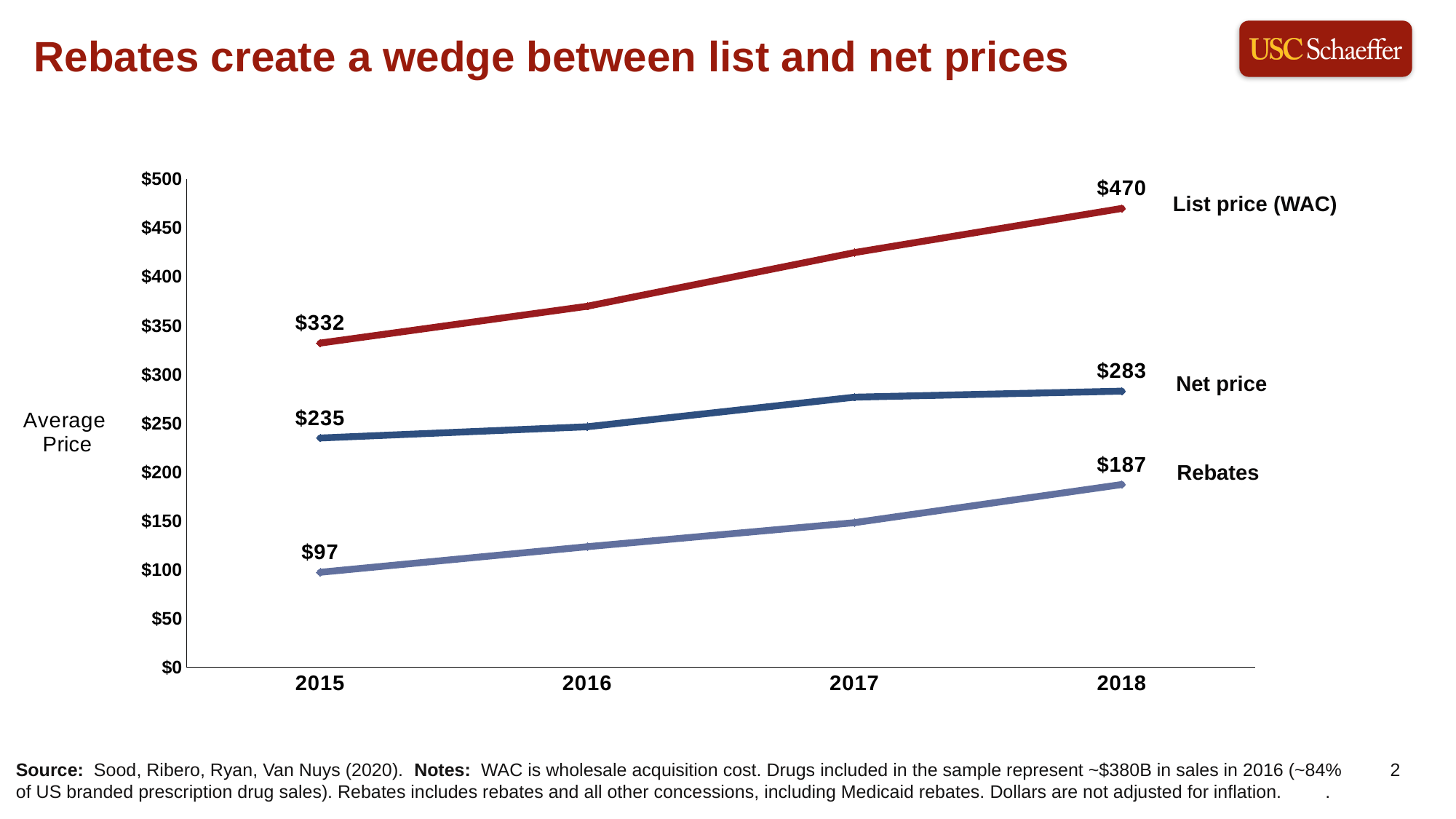
What kind of chart is shown on the slide? Line chart Which series has the highest value in 2018? List price (WAC) What was the List price (WAC) in 2015? $332 What was the Net price in 2015? $235 By how much did the List price (WAC) increase from 2015 to 2018? $138 What is the difference between the List price (WAC) and the Net price in 2018? $187 What was the List price (WAC) in 2018? $470 What was the value of Rebates in 2018? $187 How many years are shown on the x axis? 4 Is the List price (WAC) in 2017 greater or less than $400? greater By how much did Rebates increase from 2015 to 2018? $90 Which series has the lowest value in 2015? Rebates